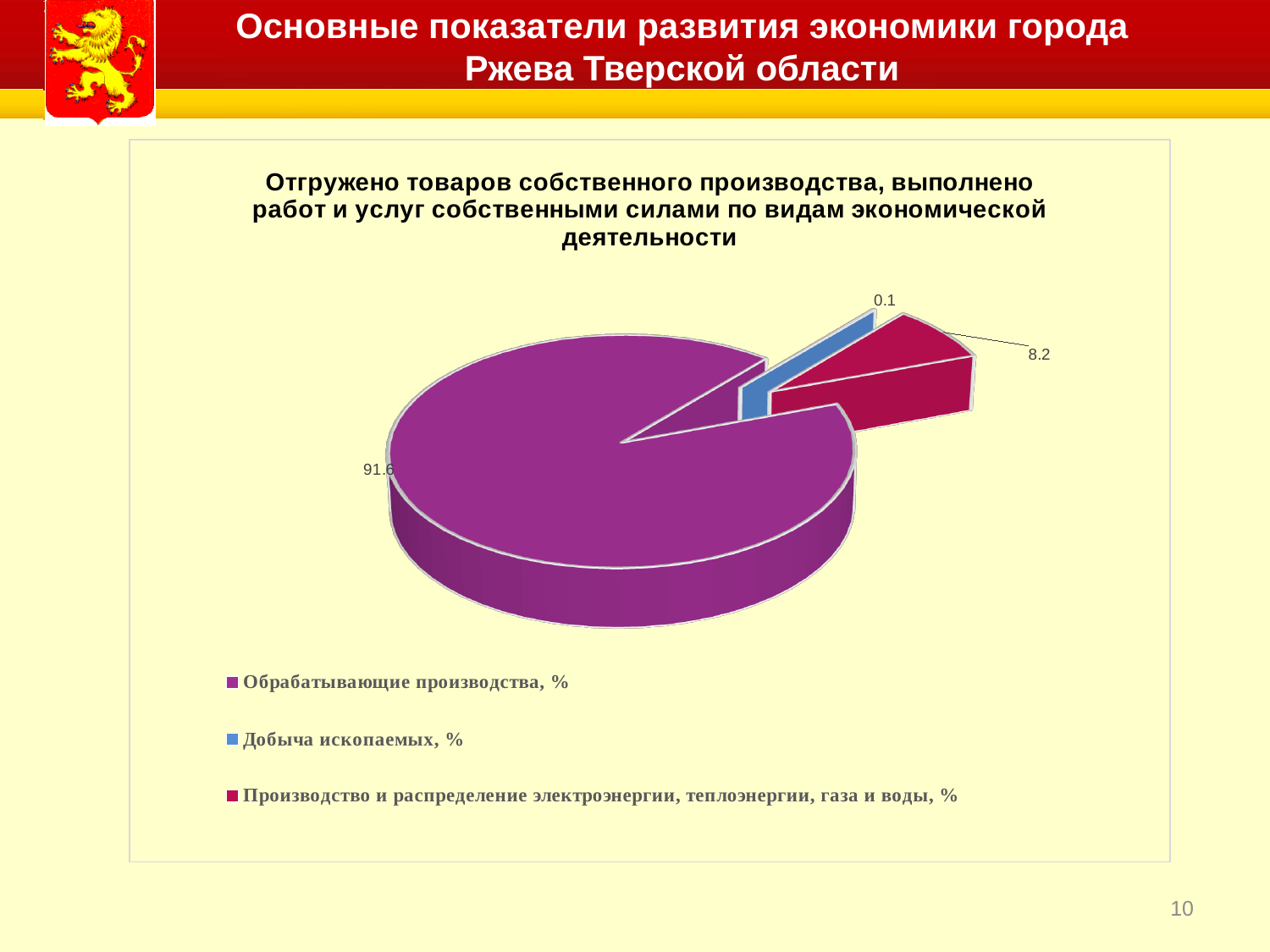
What is the value for Обрабатывающие производства, %? 91.6 What colour is the slice for Добыча ископаемых, %? blue What is the value for Производство и распределение электроэнергии, теплоэнергии, газа и воды, %? 8.2 What is the difference between the values for Обрабатывающие производства and Производство и распределение электроэнергии, теплоэнергии, газа и воды? 83.4 How many entries does the legend list? 3 Which is larger: the value for Добыча ископаемых or the value for Производство и распределение электроэнергии, теплоэнергии, газа и воды? Производство и распределение электроэнергии, теплоэнергии, газа и воды What kind of chart is shown on the slide? pie chart Which category has the smallest slice of the pie? Добыча ископаемых, % What is the difference between the values for Производство и распределение электроэнергии, теплоэнергии, газа и воды and Добыча ископаемых? 8.1 Which category has the largest slice of the pie? Обрабатывающие производства, % How many slices does the pie chart have? 3 What is the value for Добыча ископаемых, %? 0.1